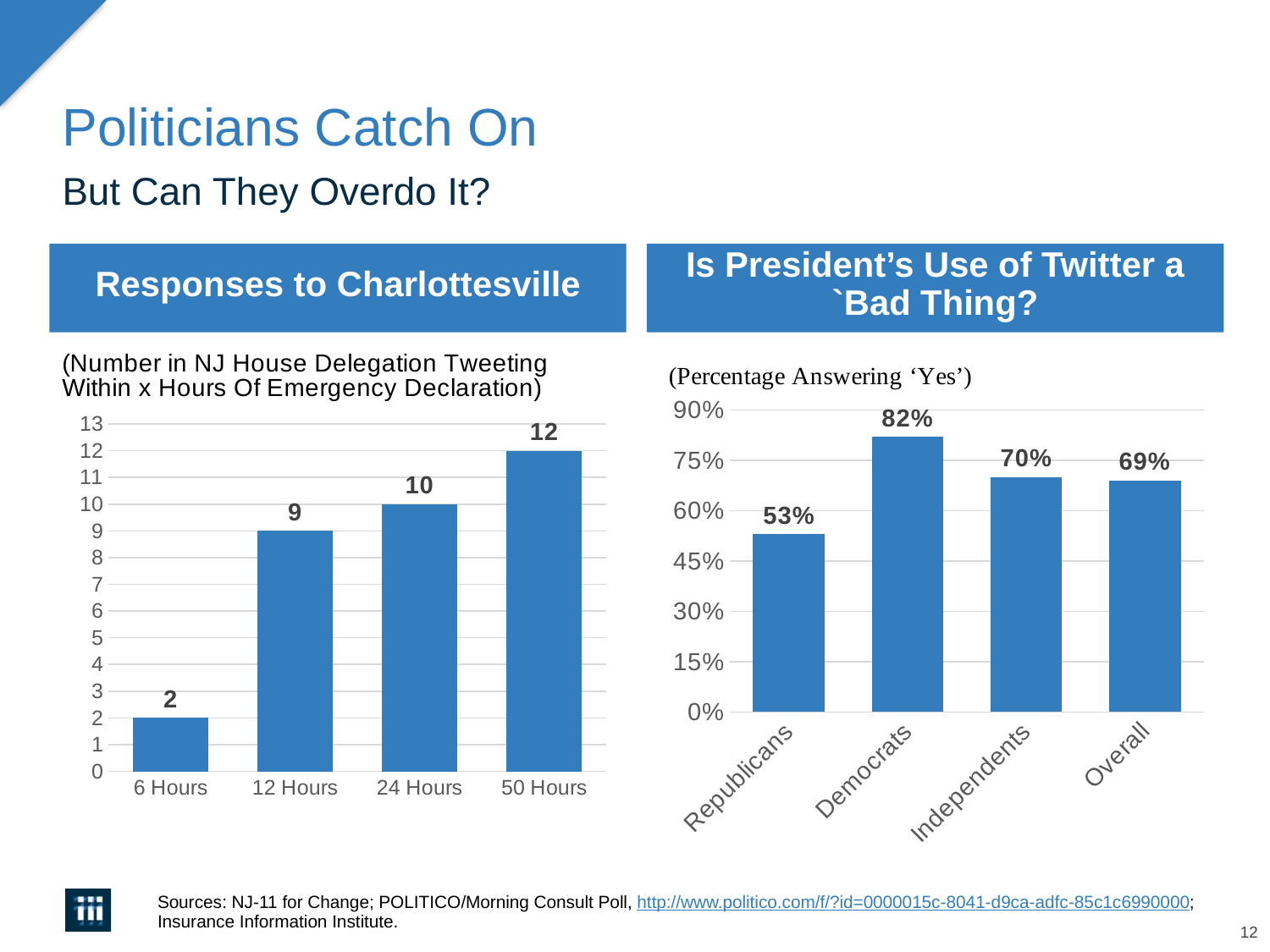
In the 'Responses to Charlottesville' chart, do the values rise or fall from 6 Hours to 50 Hours? rise In the 'Responses to Charlottesville' chart, what is the value for 12 Hours? 9 In the 'Is President's Use of Twitter a `Bad Thing?' chart, is the value for Republicans greater or less than 60%? less In the 'Is President's Use of Twitter a `Bad Thing?' chart, what is the difference between the values for Democrats and Republicans? 29% In the 'Is President's Use of Twitter a `Bad Thing?' chart, what is the value for Independents? 70% What kind of chart is the 'Responses to Charlottesville' chart? bar chart In the 'Responses to Charlottesville' chart, how many categories are shown? 4 In the 'Is President's Use of Twitter a `Bad Thing?' chart, which is larger, the value for Republicans or the value for Overall? Overall What does the subtitle under the 'Is President's Use of Twitter a `Bad Thing?' chart say the values represent? Percentage Answering 'Yes' In the 'Responses to Charlottesville' chart, what is the difference between the values for 50 Hours and 24 Hours? 2 In the 'Is President's Use of Twitter a `Bad Thing?' chart, which category has the highest value? Democrats In the 'Responses to Charlottesville' chart, which category has the lowest value? 6 Hours